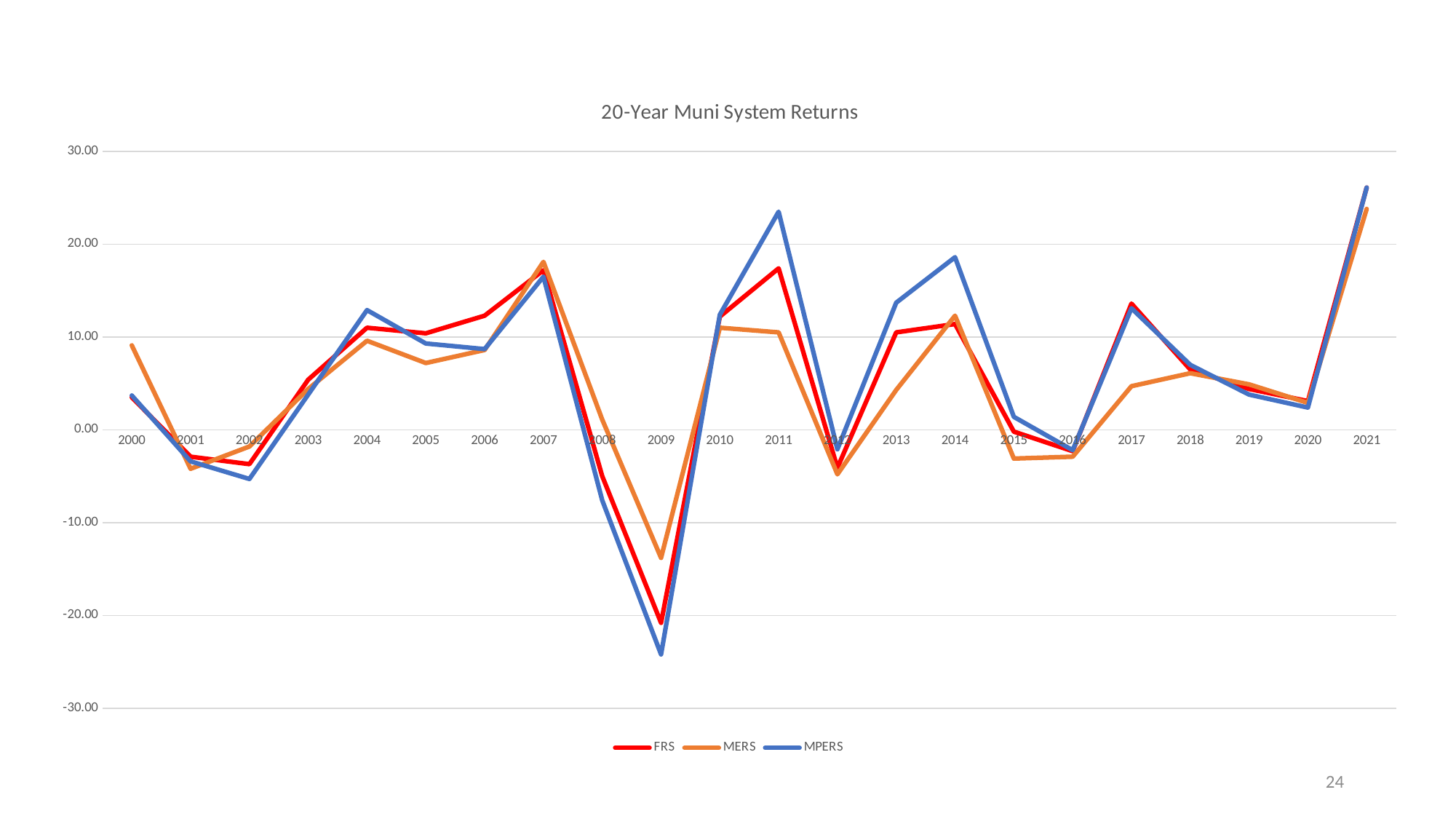
In which year does the MERS series reach its highest value? 2021 In which year does the MPERS series reach its highest value? 2021 What kind of chart is shown on the slide? line chart In which year does the MPERS series reach its lowest value? 2009 In 2011, which series has the larger value, MPERS or MERS? MPERS What is the title of the chart? 20-Year Muni System Returns Is the value for MERS in 2009 greater or less than -20.00? greater Which colour is used for the FRS series? red Is the value for MPERS in 2009 greater or less than -20.00? less How many years are plotted along the x axis? 22 How many series does the legend list? 3 Does the FRS series rise or fall from 2007 to 2009? fall